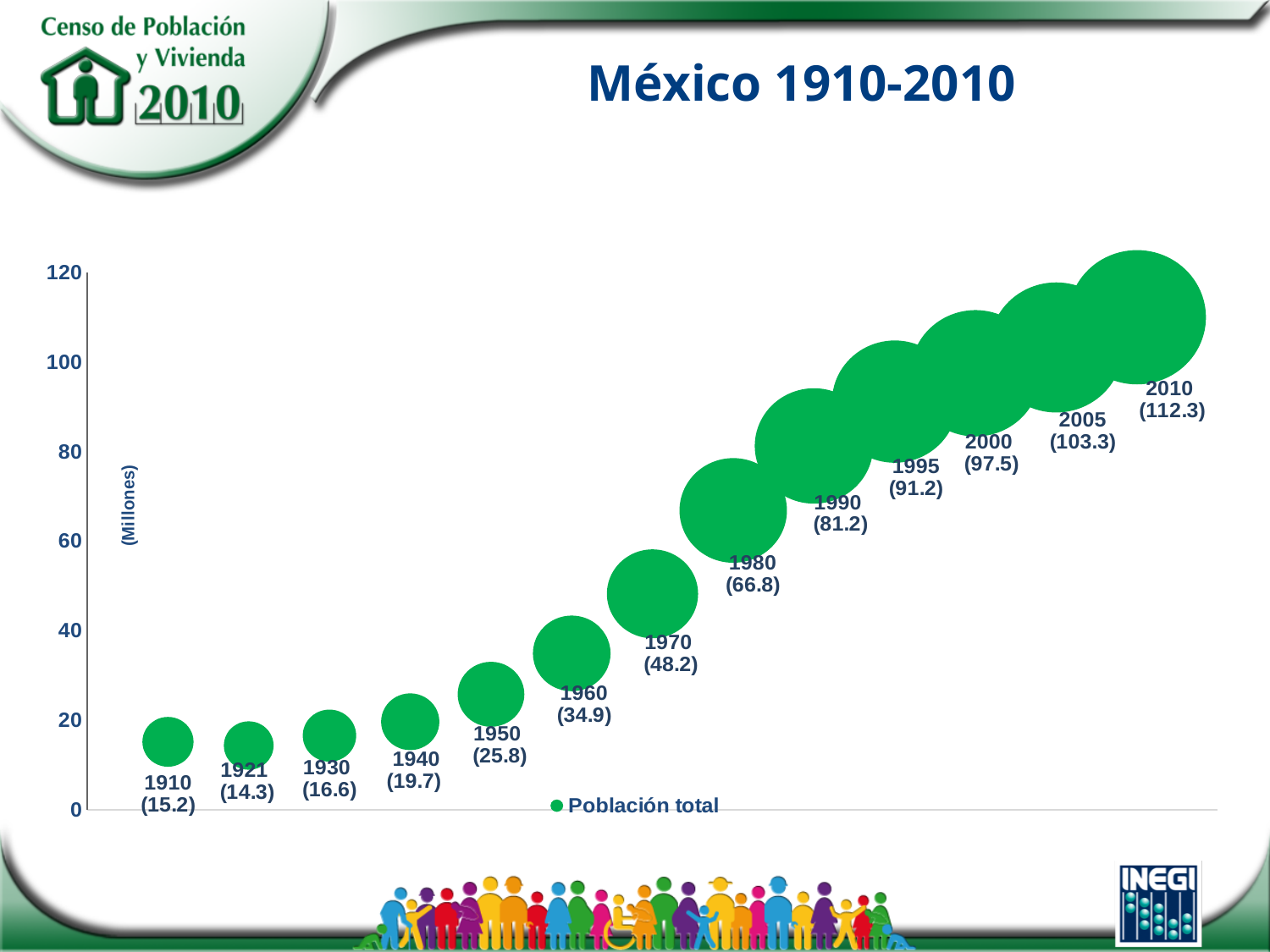
What is the population value shown for 2010? 112.3 Which is larger, the population value for 1910 or for 1921? 1910 What is the population value shown for 1980? 66.8 What is the name of the series shown in the legend? Población total What is the population value shown for 1950? 25.8 What is the difference between the population values for 2010 and 2000? 14.8 Which year has the lowest population value on the chart? 1921 Do the population values rise or fall from 1930 to 2010 along the x axis? rise Which year has the highest population value on the chart? 2010 How many series does the legend list? 1 How many data points (years) are plotted on the chart? 13 What is the difference between the population values for 1970 and 1960? 13.3